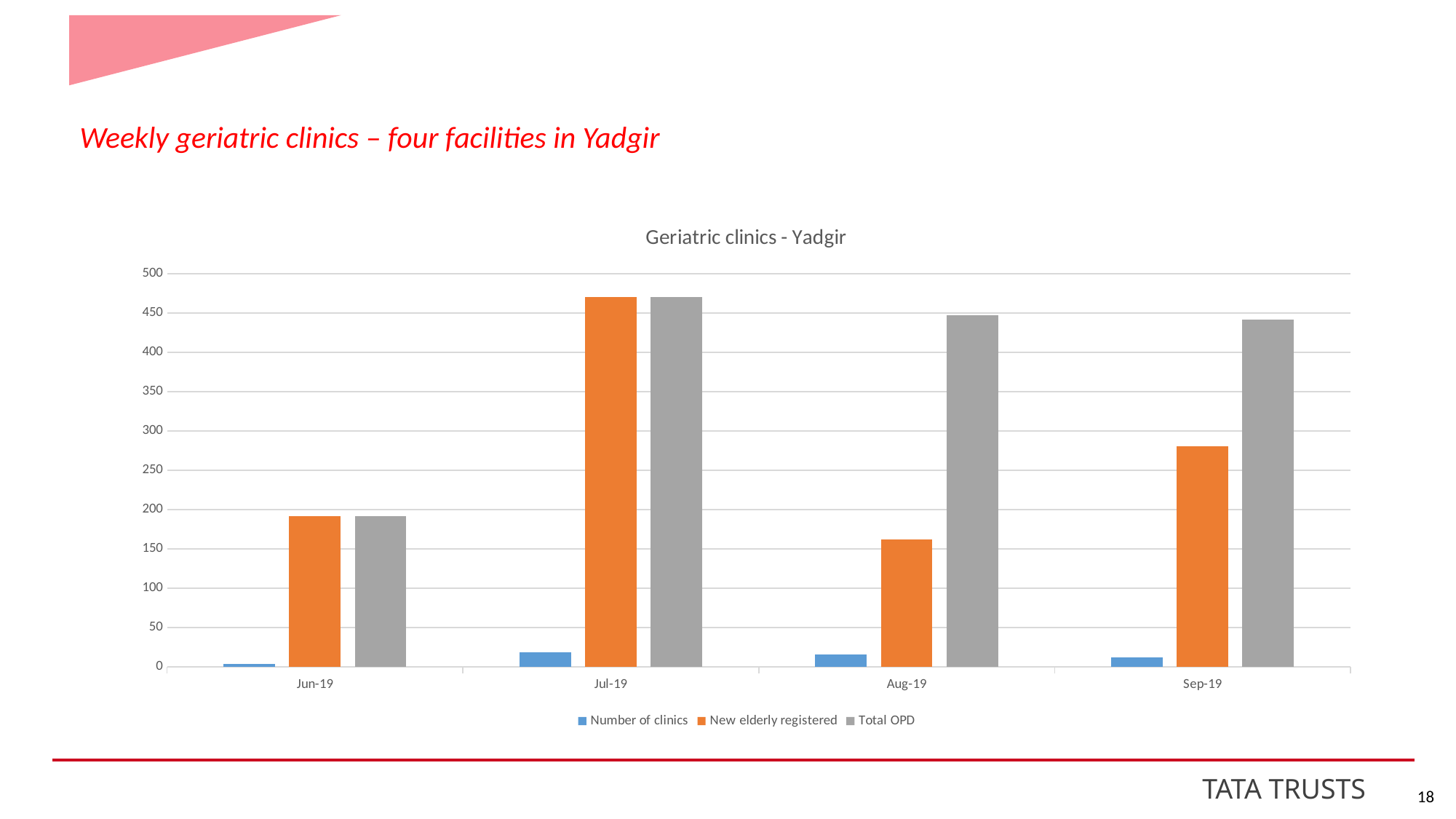
Which is larger for New elderly registered: Jun-19 or Sep-19? Sep-19 How many series does the legend of the chart list? 3 Is the value for New elderly registered in Aug-19 greater or less than 200? less Which month has the highest value for New elderly registered? Jul-19 What kind of chart is shown on the slide? bar chart What is the title of the chart? Geriatric clinics - Yadgir Is the value for Total OPD in Aug-19 greater or less than 400? greater Which month has the lowest value for Number of clinics? Jun-19 Which month has the lowest value for Total OPD? Jun-19 In Aug-19, which is larger: New elderly registered or Total OPD? Total OPD Is the value for New elderly registered in Sep-19 greater or less than 250? greater How many months are shown on the x axis of the chart? 4